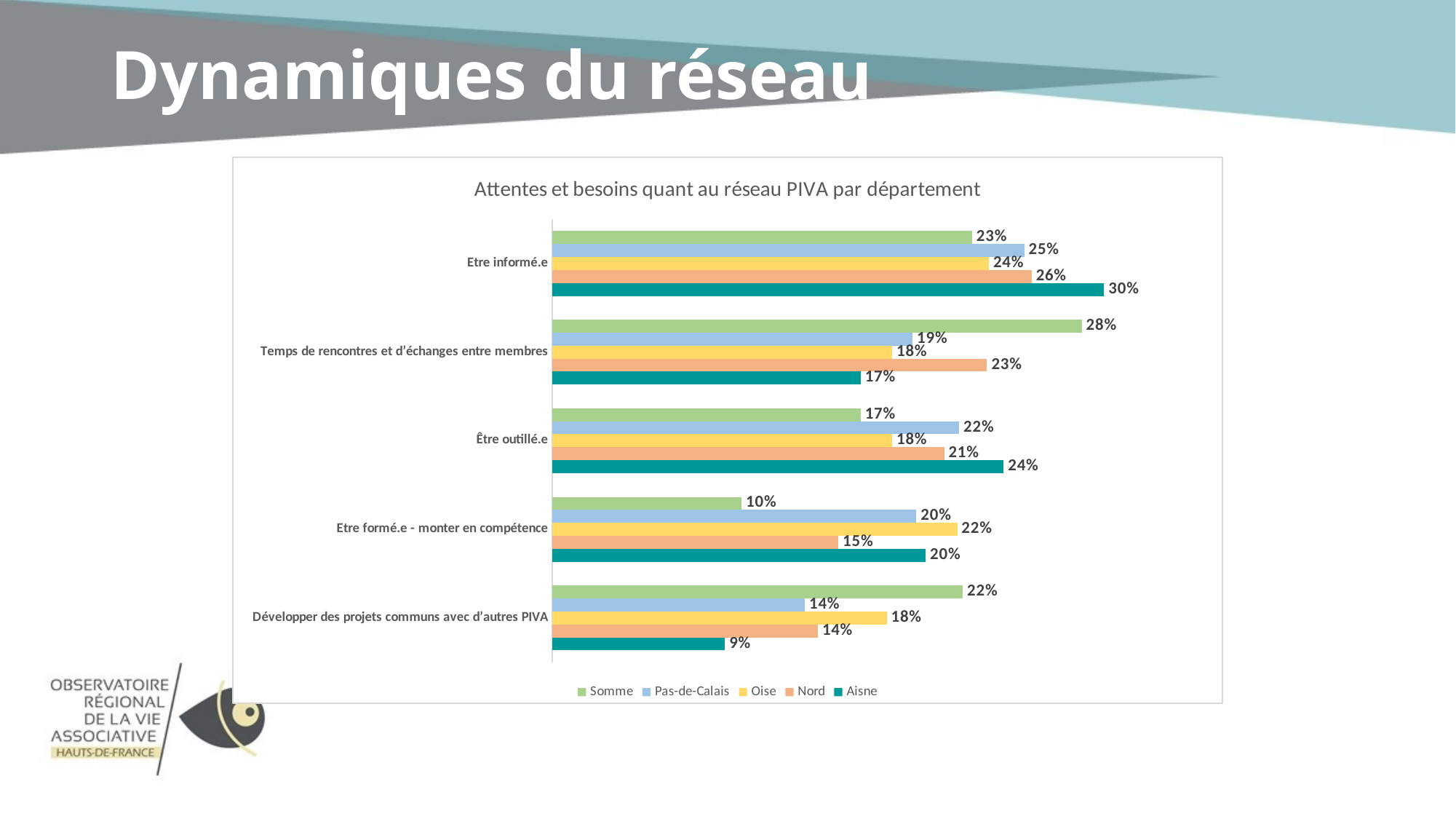
How many categories are shown on the vertical axis of the chart? 5 Which department has the highest value in the 'Être outillé.e' category? Aisne What is the value for Pas-de-Calais in the 'Développer des projets communs avec d'autres PIVA' category? 14% What is the value for Aisne in the 'Etre informé.e' category? 30% What is the value for Somme in the 'Temps de rencontres et d'échanges entre membres' category? 28% What is the difference between the Aisne and Somme values in the 'Etre informé.e' category? 7% What kind of chart is shown on the slide? Bar chart How many series does the legend list? 5 What is the value for Nord in the 'Etre formé.e - monter en compétence' category? 15% What is the title of the chart? Attentes et besoins quant au réseau PIVA par département In the 'Etre formé.e - monter en compétence' category, which is larger: the value for Oise or the value for Somme? Oise Which department has the lowest value in the 'Développer des projets communs avec d'autres PIVA' category? Aisne